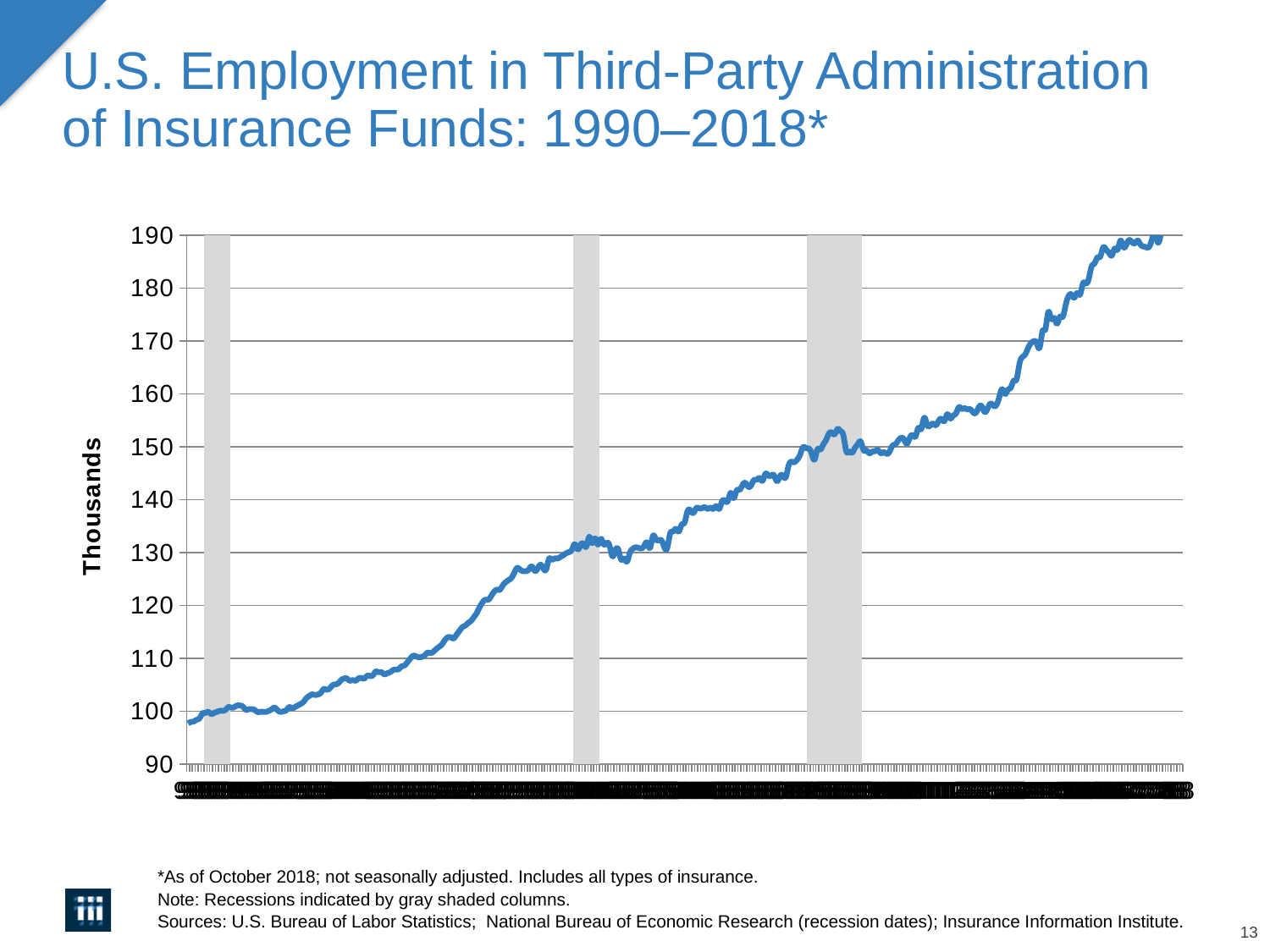
What is the label on the vertical axis? Thousands Is the highest point on the line greater or less than 170? greater How many gray shaded recession columns are shown on the chart? 3 Is the lowest point on the line greater or less than 120? less What kind of chart is shown on the slide? line chart Is the value at the end of the series (2018) greater or less than 180? greater Overall, do the values rise or fall from 1990 to 2018 along the x axis? rise